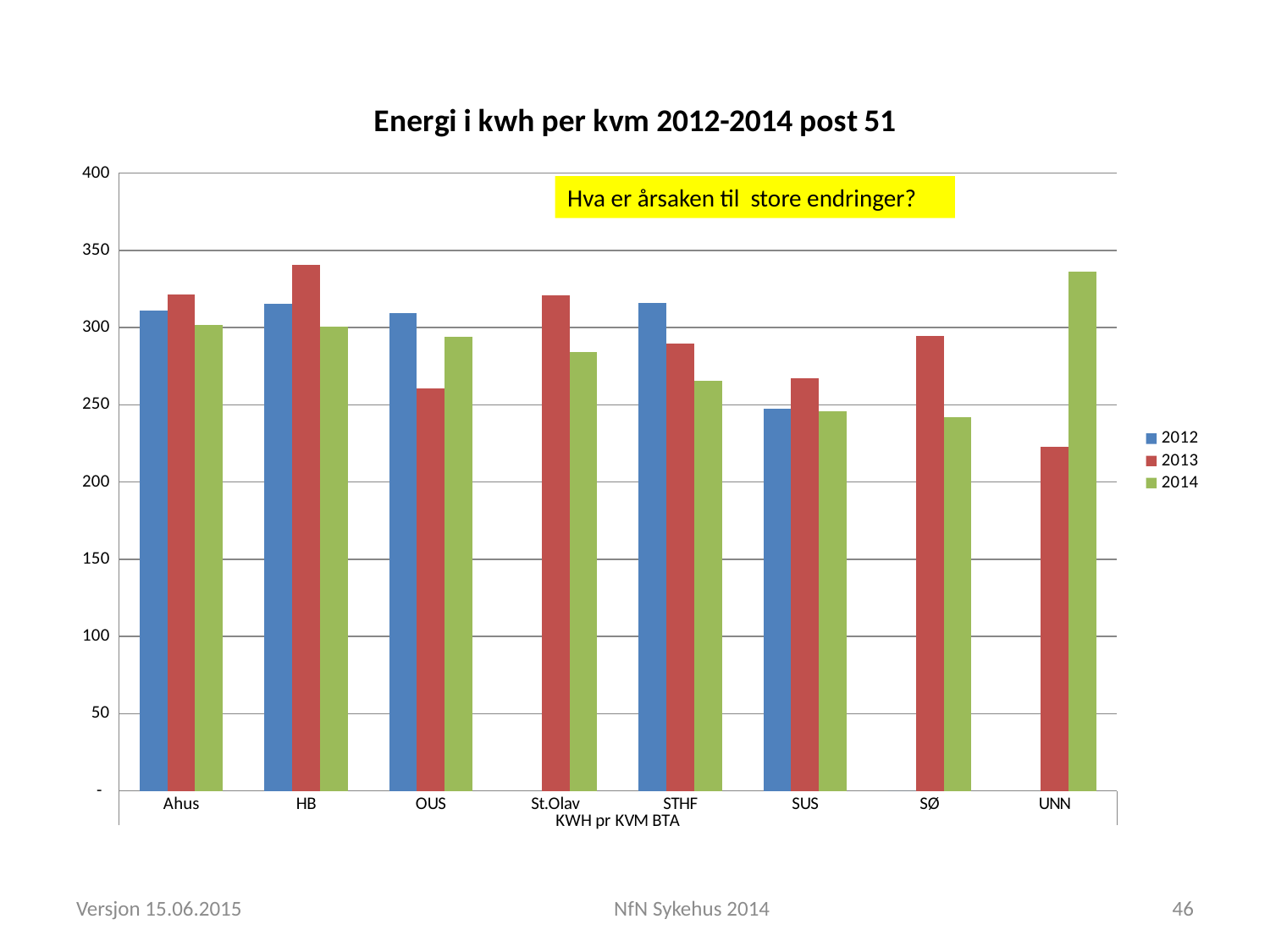
Is the 2014 value for UNN greater or less than 300? greater How many series does the legend list? 3 Which category has the lowest value for the 2012 series? SUS Which category has the highest value for the 2014 series? UNN Which category has the lowest value for the 2013 series? UNN Is the 2013 value for OUS greater or less than 300? less How many categories are shown on the x axis? 8 What is the title of the chart? Energi i kwh per kvm 2012-2014 post 51 Which category has the highest value for the 2013 series? HB Do the values for STHF rise or fall from 2012 to 2014? fall What type of chart is shown on the slide? Bar chart For UNN, which is larger: the 2013 value or the 2014 value? 2014